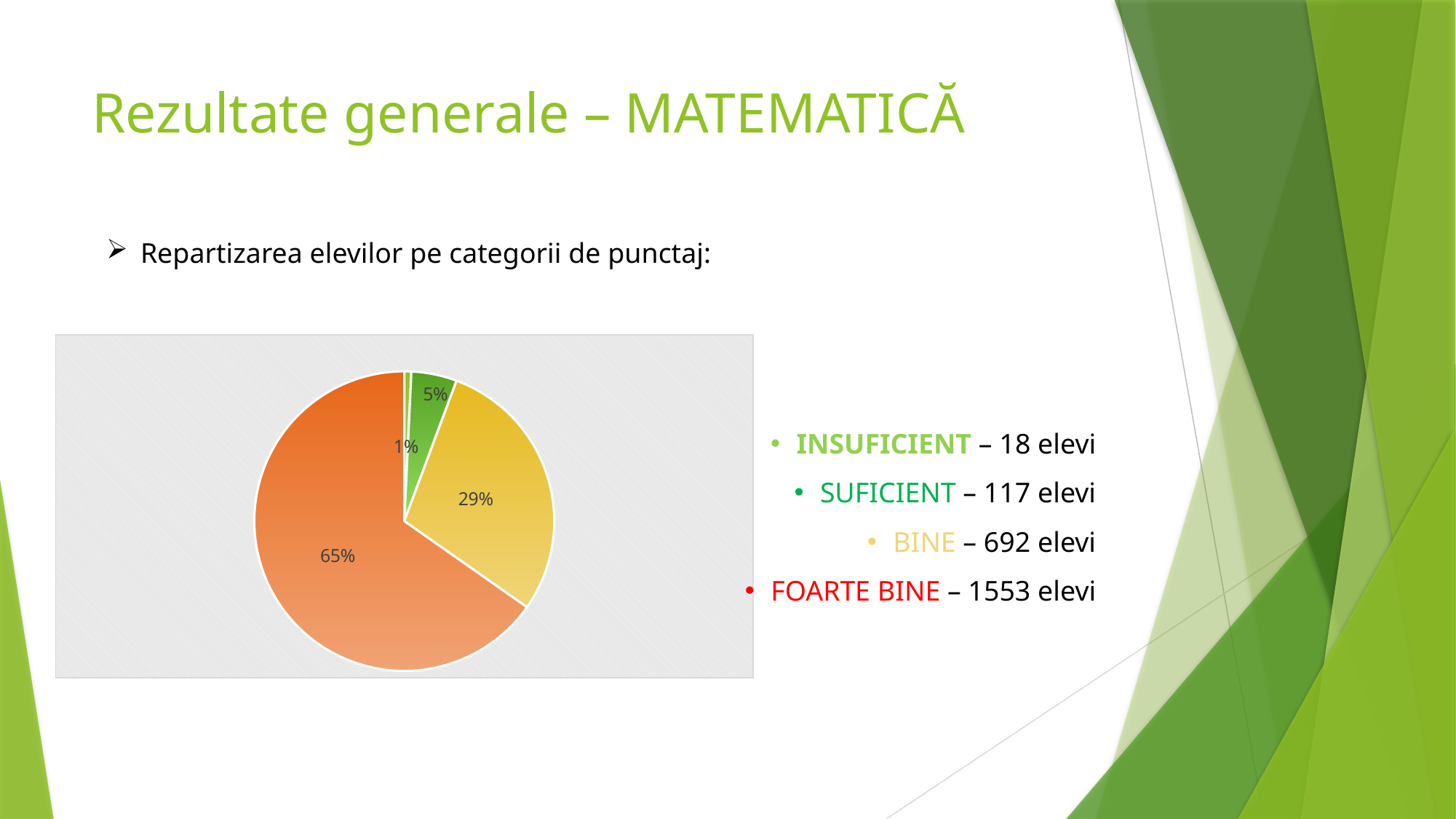
What percentage is shown on the orange slice of the pie chart? 65% What percentage is shown on the larger green slice of the pie chart? 5% What is the difference in percentage points between the 65% slice and the 29% slice? 36 What is the percentage shown on the smallest slice of the pie chart? 1% According to the text beside the chart, how many students (elevi) are in the FOARTE BINE category? 1553 elevi According to the text beside the chart, how many students (elevi) are in the BINE category? 692 elevi What is the percentage shown on the largest slice of the pie chart? 65% What percentage is shown on the yellow slice of the pie chart? 29% What kind of chart is shown on the slide? pie chart Which is larger in the pie chart, the yellow slice or the orange slice? the orange slice How many slices does the pie chart have? 4 Is the share of the orange slice greater or less than 50%? greater